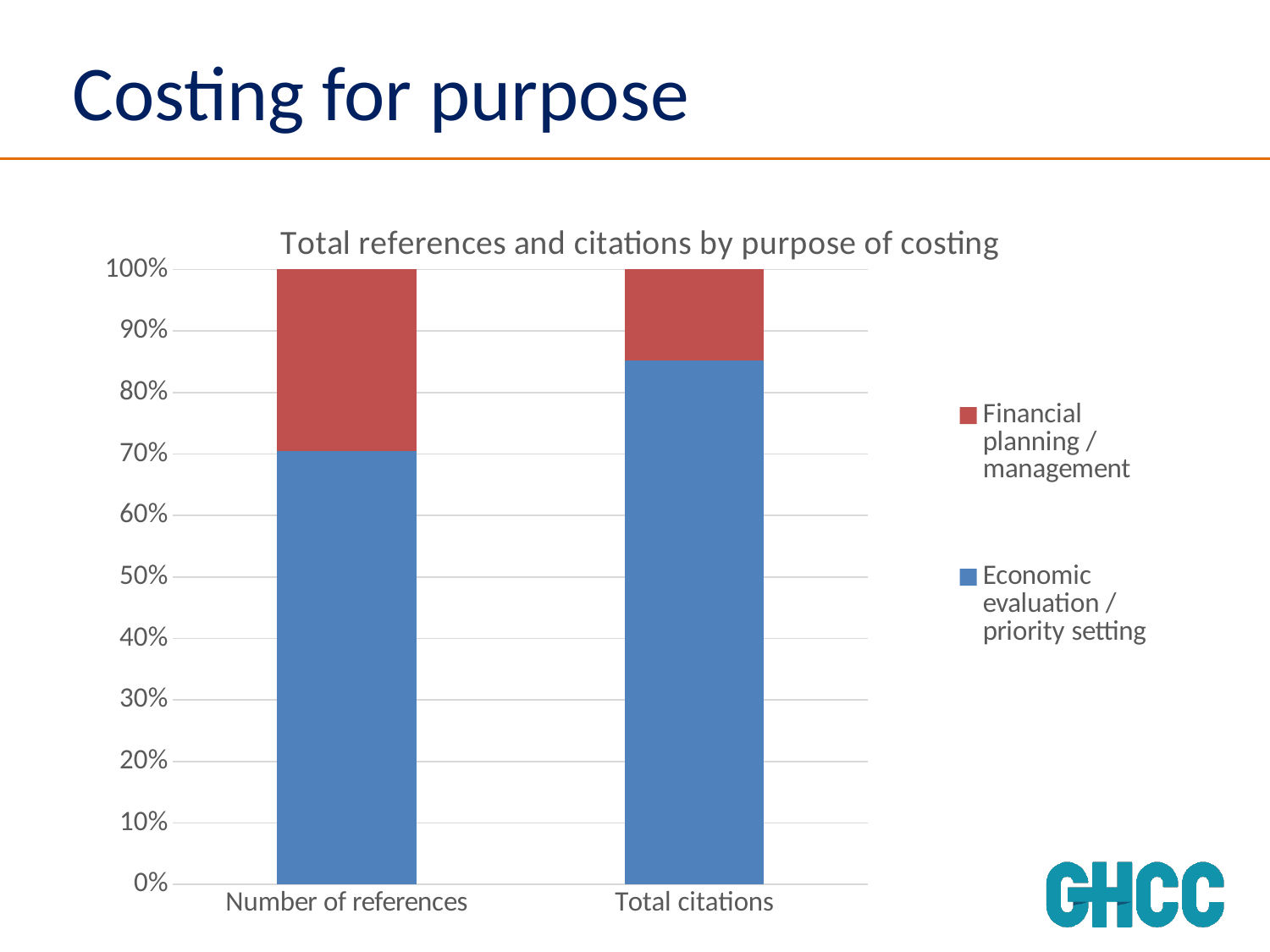
How many categories are shown on the x axis of the chart? 2 Is the Economic evaluation / priority setting share for Number of references greater or less than 60%? greater Which category has the larger Financial planning / management share, Number of references or Total citations? Number of references What kind of chart is shown on the slide? Stacked bar chart What is the title of the chart? Total references and citations by purpose of costing Is the Economic evaluation / priority setting share for Total citations greater or less than 90%? less Is the Economic evaluation / priority setting share for Total citations greater or less than 80%? greater How many series does the chart's legend list? 2 Which series is shown in blue in the chart? Economic evaluation / priority setting What is the total height of the stacked bar for Total citations? 100% Does the Economic evaluation / priority setting share rise or fall from Number of references to Total citations? Rise